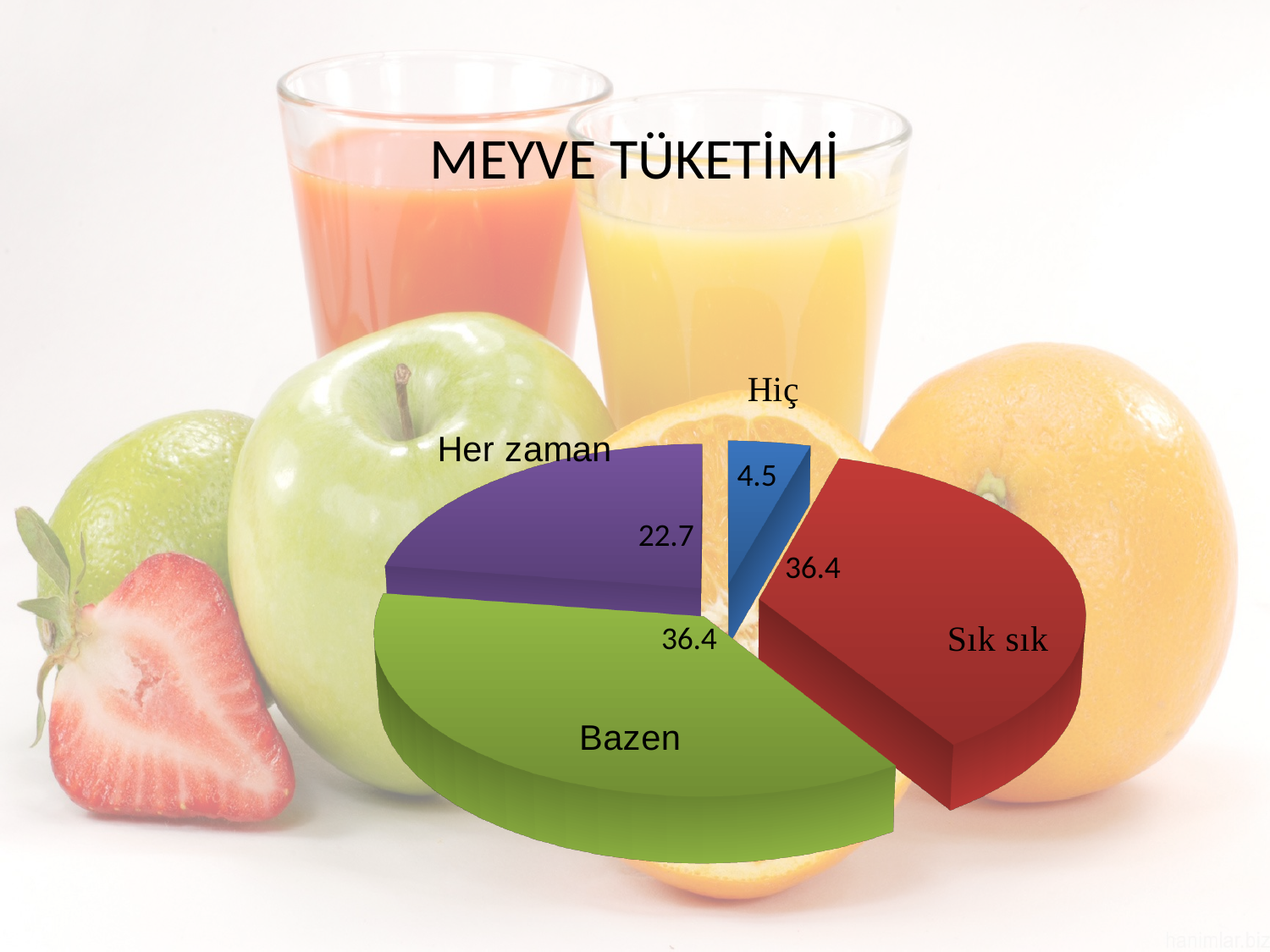
Which category has the smallest slice? Hiç What is the value for Bazen? 36.4 How many slices does the pie chart have? 4 What is the value for Sık sık? 36.4 What is the difference between the values for Her zaman and Hiç? 18.2 What is the value for Hiç? 4.5 Which is larger, Her zaman or Hiç? Her zaman What kind of chart is shown on the slide? pie chart What is the difference between the values for Sık sık and Her zaman? 13.7 What is the value for Her zaman? 22.7 What is the title of the chart? MEYVE TÜKETİMİ What colour is the Bazen slice? green